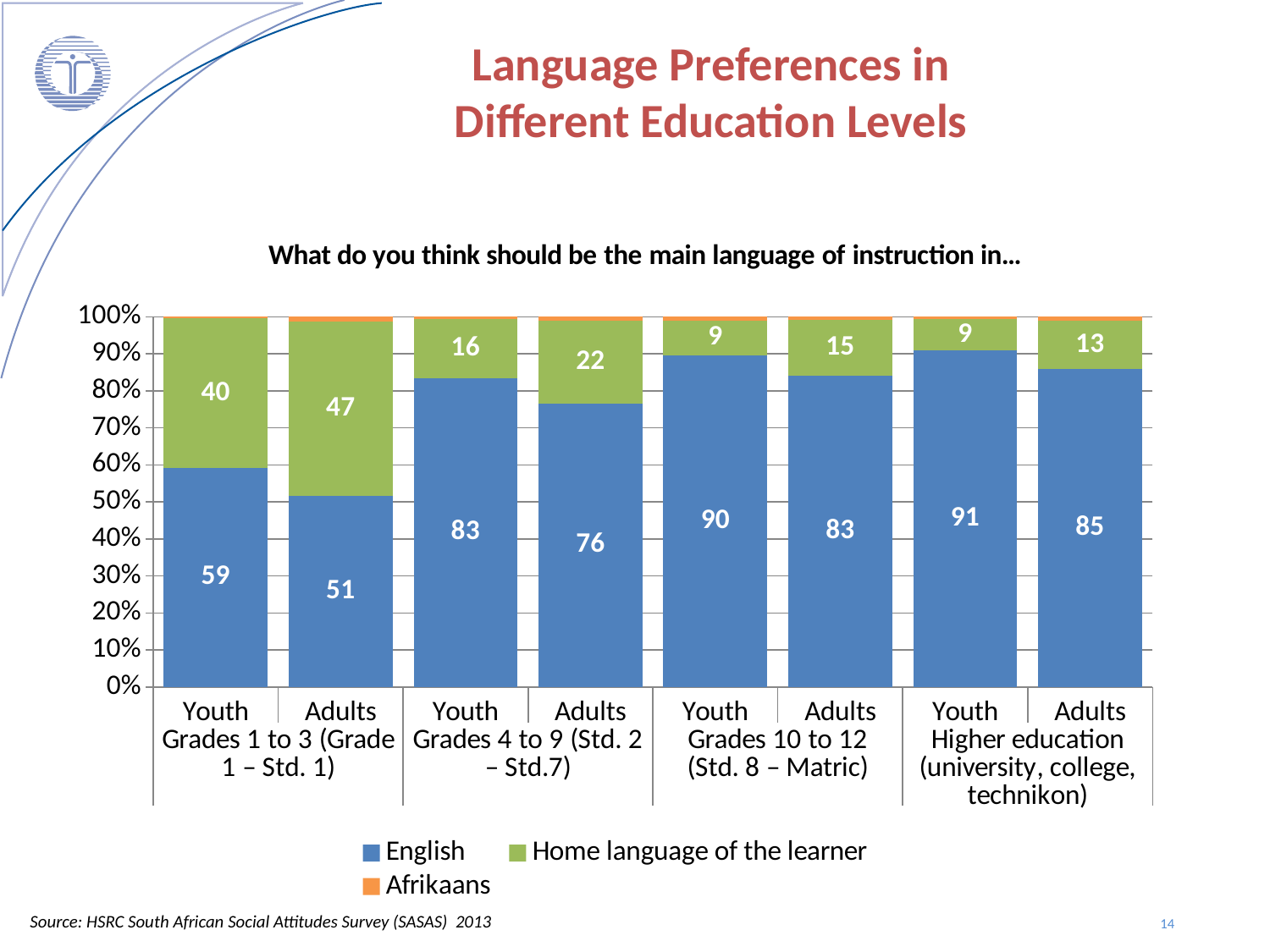
What is the English value for Youth in Grades 1 to 3 (Grade 1 – Std. 1)? 59 Which group has the lowest English value? Adults, Grades 1 to 3 (Grade 1 – Std. 1) What is the difference between the English values for Youth and Adults in Grades 10 to 12 (Std. 8 – Matric)? 7 Which group has the highest English value? Youth, Higher education (university, college, technikon) Which is larger: the Home language of the learner value for Youth in Grades 4 to 9 or for Adults in Grades 4 to 9? Adults in Grades 4 to 9 What is the Home language of the learner value for Adults in Higher education (university, college, technikon)? 13 Which series is shown in orange in the legend? Afrikaans What is the English value for Adults in Grades 4 to 9 (Std. 2 – Std.7)? 76 How many bars are plotted in the chart? 8 What is the Home language of the learner value for Adults in Grades 1 to 3 (Grade 1 – Std. 1)? 47 What kind of chart is shown on the slide? Stacked bar chart How many series does the legend list? 3